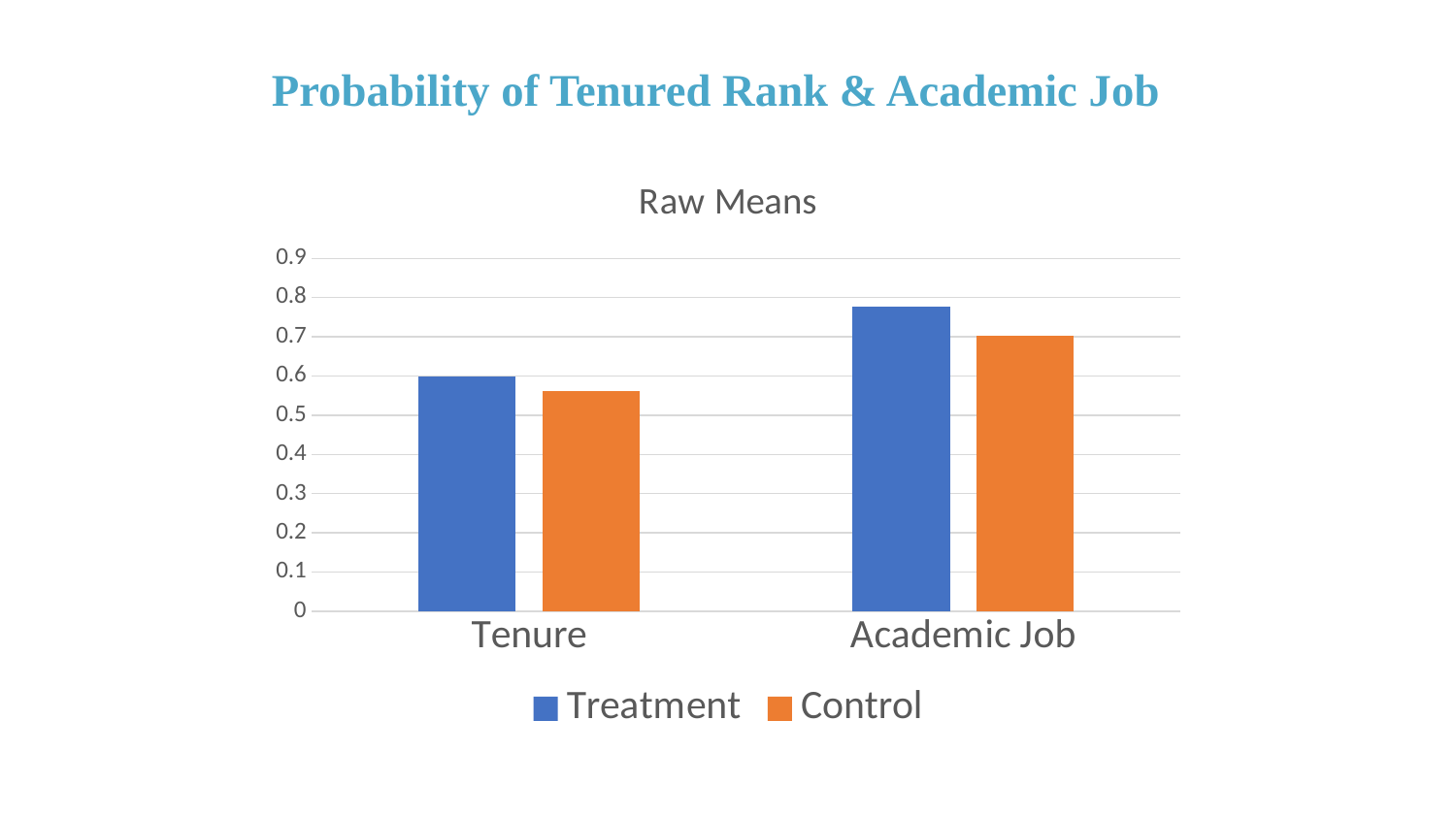
Which bar is the highest in the chart? Treatment for Academic Job For Tenure, which is larger, Treatment or Control? Treatment Is the Control value for Tenure greater or less than 0.6? less What is the title of the chart? Raw Means How many series does the legend list? 2 What kind of chart is shown on the slide? Bar chart How many categories are shown on the x axis? 2 Which series is shown in orange? Control Is the Control value for Academic Job greater or less than 0.8? less For Academic Job, which is larger, Treatment or Control? Treatment Which bar is the lowest in the chart? Control for Tenure Is the Treatment value for Academic Job greater or less than 0.7? greater